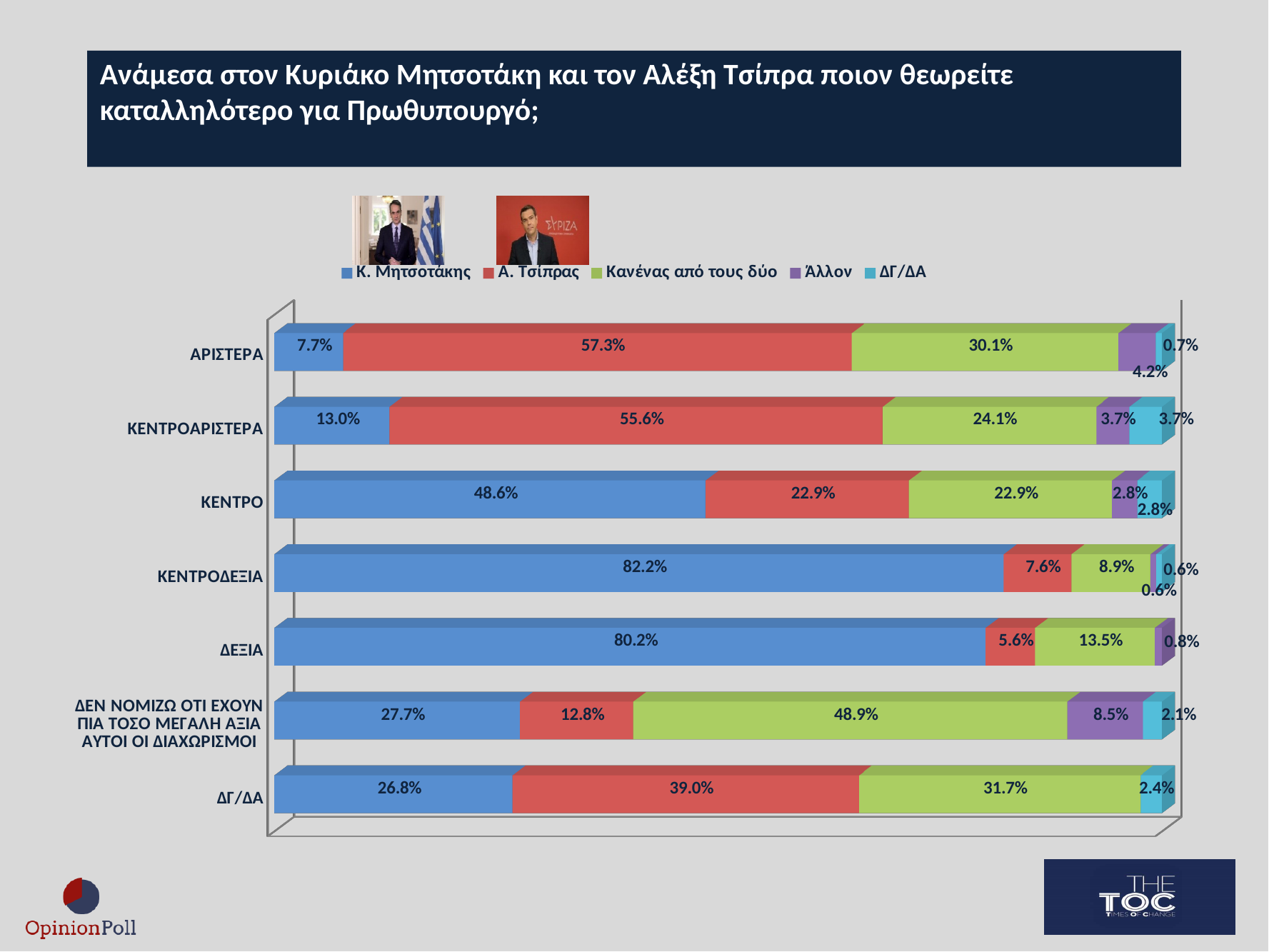
Which is larger: the Α. Τσίπρας value for ΔΓ/ΔΑ or the Κανένας από τους δύο value for ΔΓ/ΔΑ? Α. Τσίπρας (39.0%) What is the value for Α. Τσίπρας in the ΑΡΙΣΤΕΡΑ category? 57.3% How many categories (bars) are shown on the chart? 7 What is the difference between the Κ. Μητσοτάκης values for ΚΕΝΤΡΟΔΕΞΙΑ and ΔΕΞΙΑ? 2.0% What is the value for Άλλον in the ΚΕΝΤΡΟΑΡΙΣΤΕΡΑ category? 3.7% How many series does the legend list? 5 In which category does Κ. Μητσοτάκης have the highest value? ΚΕΝΤΡΟΔΕΞΙΑ What is the value for Κ. Μητσοτάκης in the ΚΕΝΤΡΟ category? 48.6% Which series is shown in red in the legend? Α. Τσίπρας In which category does Κ. Μητσοτάκης have the lowest value? ΑΡΙΣΤΕΡΑ What kind of chart is shown on the slide? Stacked bar chart What is the value for Κανένας από τους δύο in the ΔΕΝ ΝΟΜΙΖΩ ΟΤΙ ΕΧΟΥΝ ΠΙΑ ΤΟΣΟ ΜΕΓΑΛΗ ΑΞΙΑ ΑΥΤΟΙ ΟΙ ΔΙΑΧΩΡΙΣΜΟΙ category? 48.9%